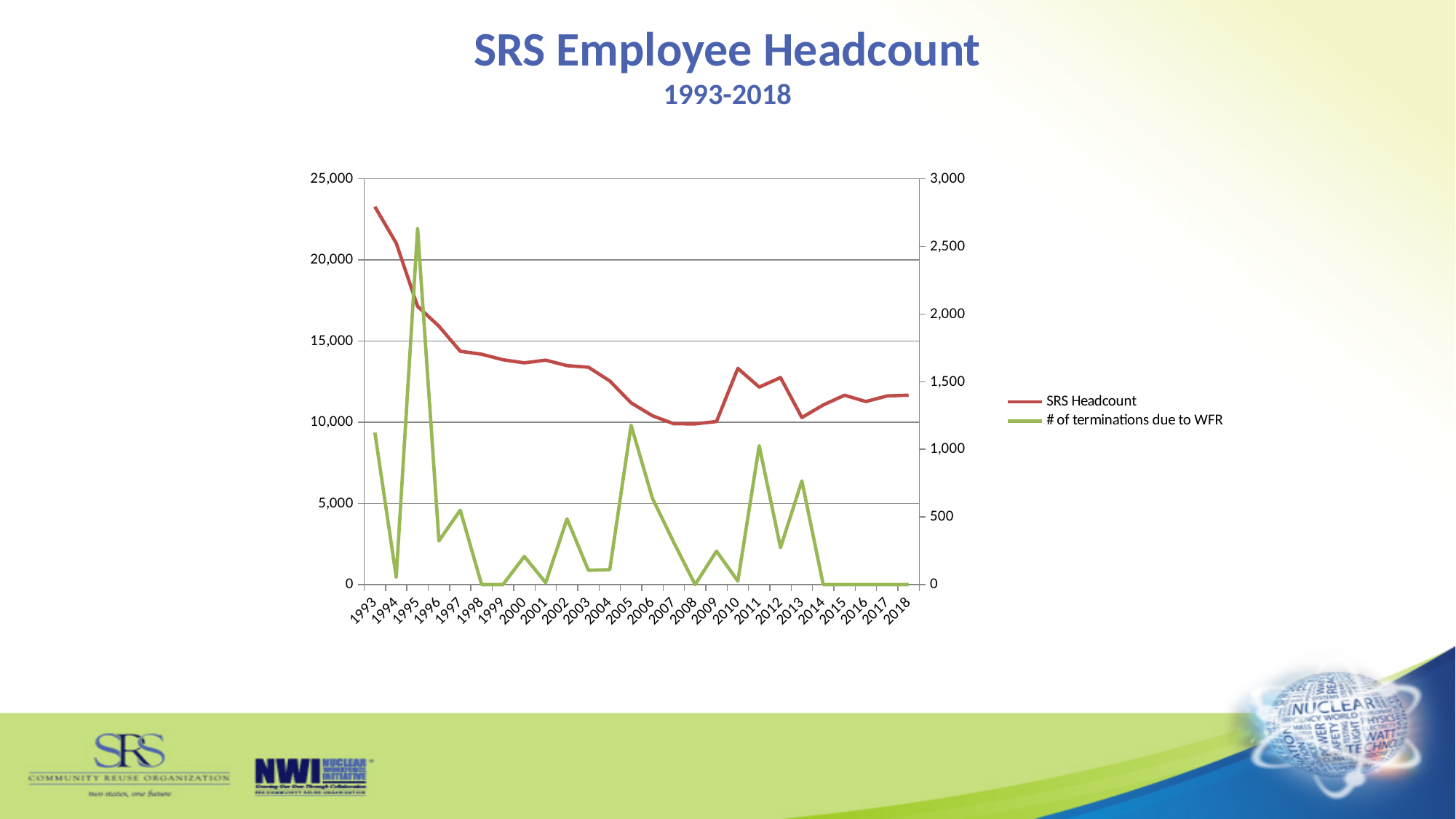
Which year has the larger SRS Headcount, 1993 or 2018? 1993 In which year is the SRS Headcount highest? 1993 Is the number of terminations due to WFR for 1995 greater or less than 2,000? greater Is the SRS Headcount for 2008 greater or less than 15,000? less How many years are plotted along the x axis? 26 How many series does the legend list? 2 Is the SRS Headcount for 1993 greater or less than 20,000? greater What colour is the line for # of terminations due to WFR? green Does the SRS Headcount rise or fall from 1993 to 2008? fall What kind of chart is shown on the slide? line chart In which year is the number of terminations due to WFR highest? 1995